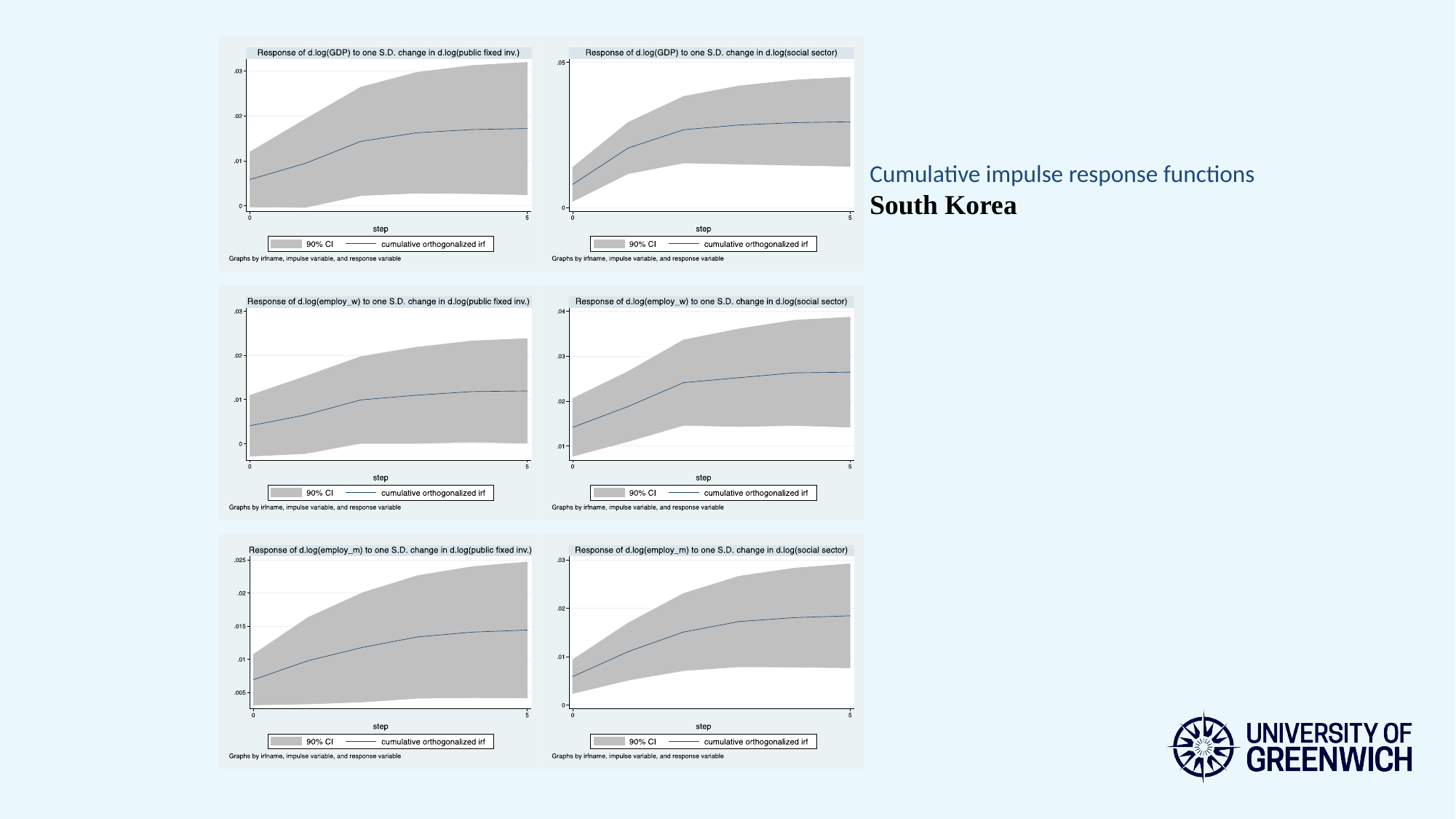
In the top-left chart (response of d.log(GDP) to public fixed inv.), does the cumulative orthogonalized irf line rise or fall as step increases from 0 to 5? Rise In the top-right chart (response of d.log(GDP) to social sector), is the cumulative orthogonalized irf at step 5 greater or less than .05? less In the bottom-left chart (response of d.log(employ_m) to public fixed inv.), is the cumulative orthogonalized irf at step 0 greater or less than .01? less In the middle-right chart (response of d.log(employ_w) to social sector), does the cumulative orthogonalized irf line rise or fall from step 0 to step 5? Rise How many entries does the legend list in the middle-left chart (response of d.log(employ_w) to public fixed inv.)? 2 In the middle-right chart (response of d.log(employ_w) to social sector), is the cumulative orthogonalized irf at step 5 greater or less than .02? greater What is the x-axis label on the bottom-right chart (response of d.log(employ_m) to social sector)? step What kind of chart is the top-left chart, 'Response of d.log(GDP) to one S.D. change in d.log(public fixed inv.)'? Line chart What confidence level does the shaded band represent in the legend of the top-right chart (response of d.log(GDP) to social sector)? 90% CI